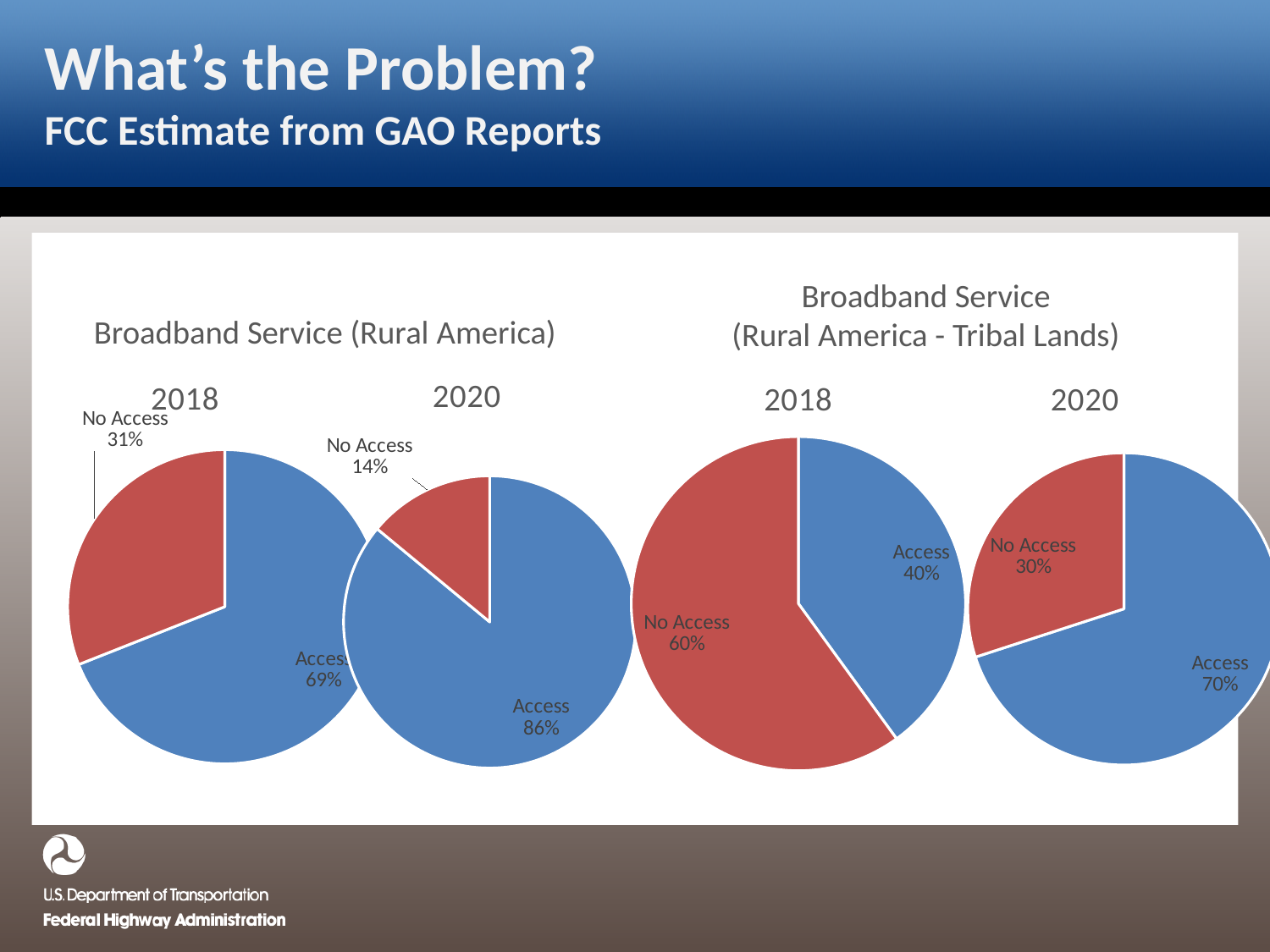
In the Broadband Service (Rural America - Tribal Lands) 2018 pie chart, which slice is larger, Access or No Access? No Access In the Broadband Service (Rural America) 2020 pie chart, what share has Access? 86% In the Broadband Service (Rural America - Tribal Lands) 2018 pie chart, what share has No Access? 60% In the Broadband Service (Rural America) 2020 pie chart, which slice is the smallest? No Access What kind of charts are shown on the slide? Pie charts In the Broadband Service (Rural America - Tribal Lands) 2020 pie chart, what share has Access? 70% What is the difference between the Access share in the Tribal Lands 2020 pie chart and the Access share in the Tribal Lands 2018 pie chart? 30% What colour is the No Access slice in the pie charts? Red In the Broadband Service (Rural America) 2018 pie chart, what share has No Access? 31% How many slices does the Broadband Service (Rural America - Tribal Lands) 2020 pie chart have? 2 How many pie charts are shown on the slide? 4 What is the difference between the No Access share in the Rural America 2018 pie chart and the No Access share in the Rural America 2020 pie chart? 17%